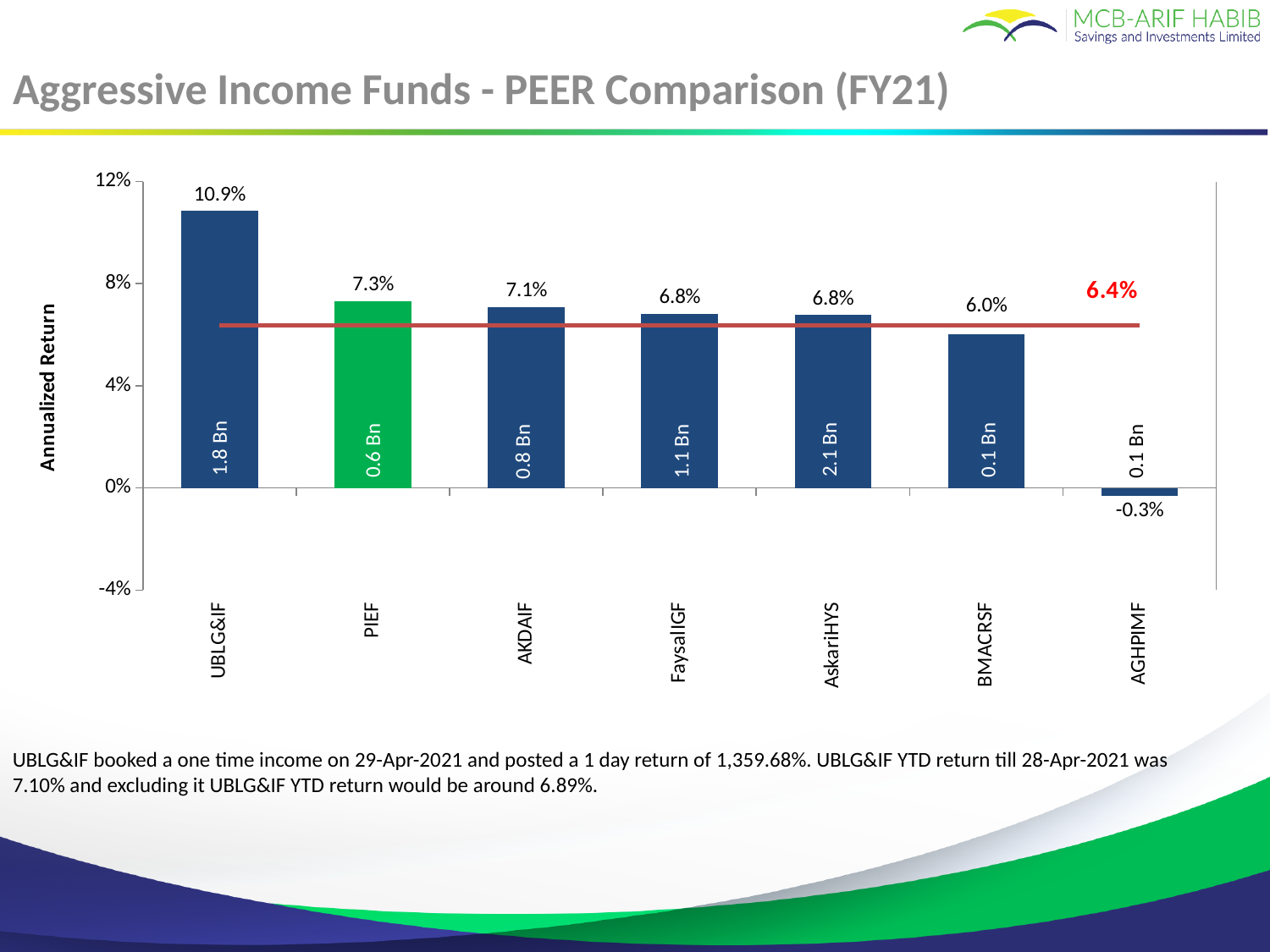
What is the difference in annualized return between UBLG&IF and PIEF? 3.6% Which has a higher annualized return, AKDAIF or BMACRSF? AKDAIF What fund size label is shown on the AskariHYS bar? 2.1 Bn Which fund has the lowest annualized return? AGHPIMF What type of chart is shown on the slide? Bar chart Which fund has the highest annualized return? UBLG&IF What is the title of the y axis? Annualized Return What is the annualized return for AGHPIMF? -0.3% What is the annualized return for PIEF? 7.3% What is the annualized return for BMACRSF? 6.0% What value is labelled on the red horizontal line? 6.4% How many funds are shown on the chart? 7